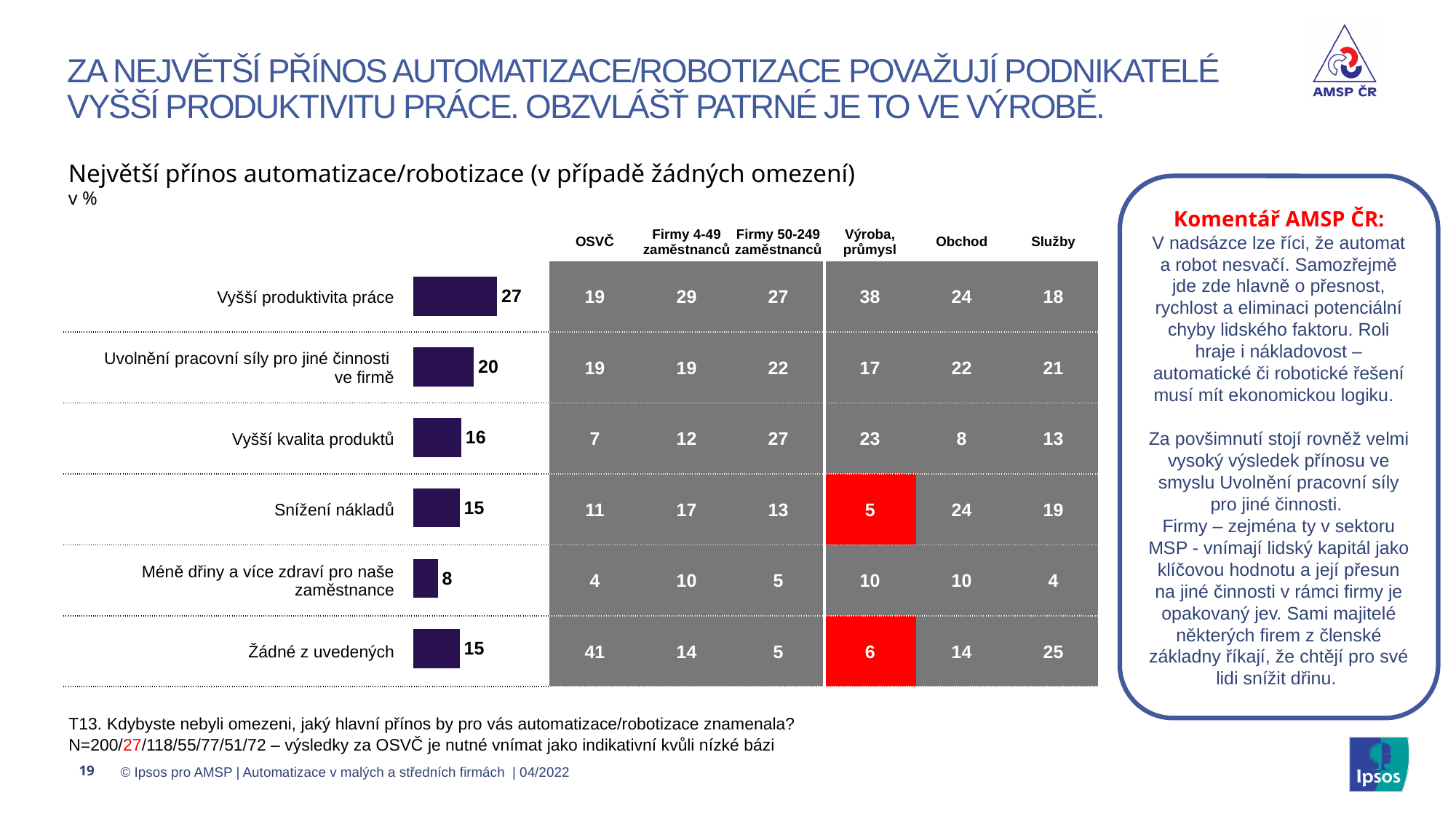
Which is larger: the value for "Uvolnění pracovní síly pro jiné činnosti ve firmě" or for "Snížení nákladů"? Uvolnění pracovní síly pro jiné činnosti ve firmě What is the difference between the values for "Vyšší produktivita práce" and "Vyšší kvalita produktů"? 11 In the table next to the chart, what is the value for "Vyšší produktivita práce" in the "Výroba, průmysl" column? 38 Which category has the lowest value in the bar chart? Méně dřiny a více zdraví pro naše zaměstnance How many categories are shown in the bar chart? 6 What is the value for "Méně dřiny a více zdraví pro naše zaměstnance" in the bar chart? 8 What kind of chart is shown on the slide? bar chart What is the value for "Uvolnění pracovní síly pro jiné činnosti ve firmě" in the bar chart? 20 What is the value for "Vyšší produktivita práce" in the bar chart? 27 Which category has the highest value in the bar chart? Vyšší produktivita práce In the table next to the chart, what is the value for "Žádné z uvedených" in the "OSVČ" column? 41 What unit is stated under the chart title? v %